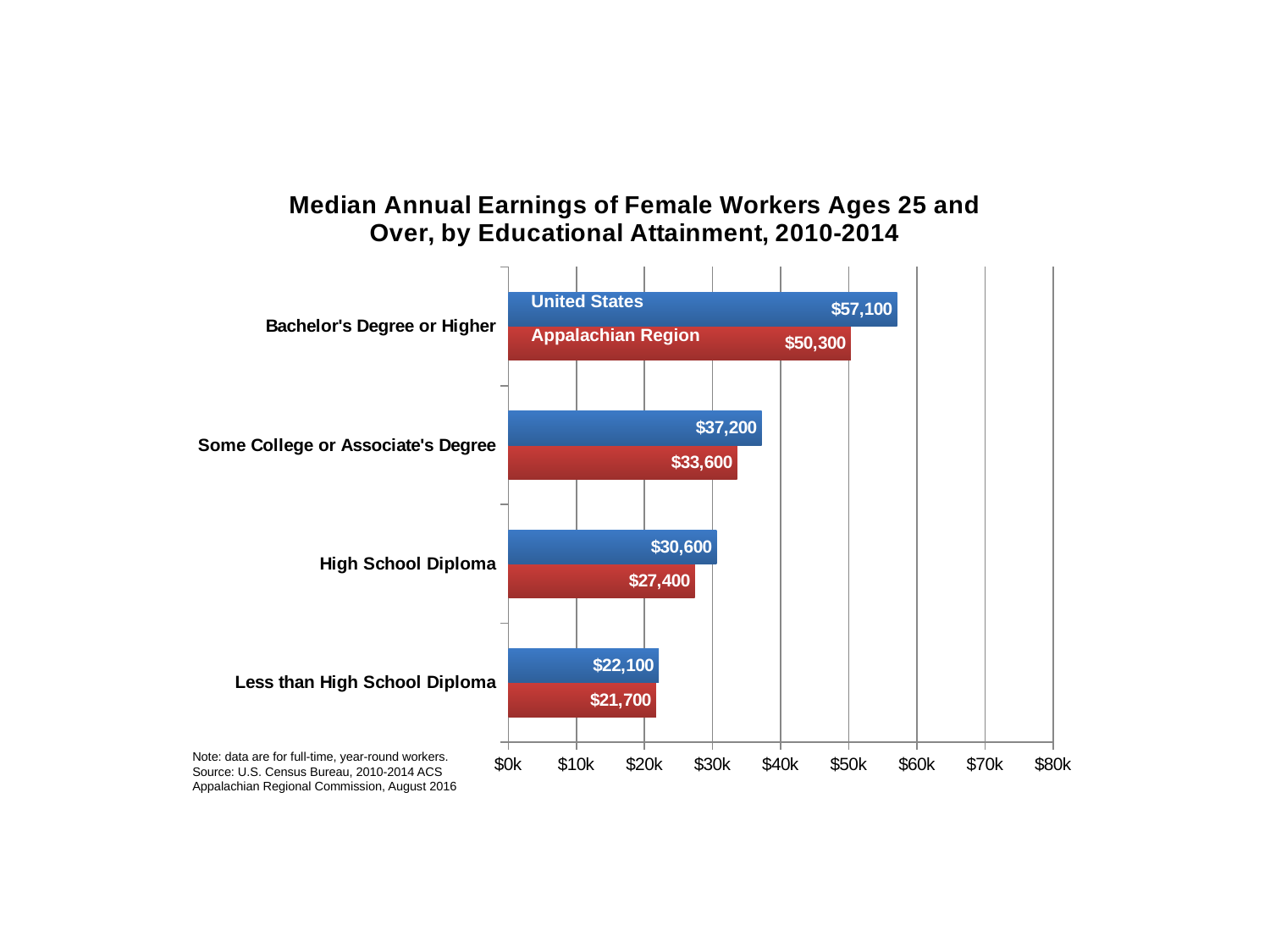
How many educational attainment categories are shown on the chart? 4 Which educational attainment category has the highest median annual earnings for the United States? Bachelor's Degree or Higher Which educational attainment category has the lowest median annual earnings for the Appalachian Region? Less than High School Diploma How many series does the chart show? 2 Which series is shown in red? Appalachian Region Which is larger: United States earnings for High School Diploma or Appalachian Region earnings for Some College or Associate's Degree? Appalachian Region earnings for Some College or Associate's Degree What is the median annual earnings for United States female workers with a Bachelor's Degree or Higher? $57,100 What is the difference between United States and Appalachian Region median earnings for Bachelor's Degree or Higher? $6,800 What is the median annual earnings for Appalachian Region female workers with Some College or Associate's Degree? $33,600 What is the median annual earnings for Appalachian Region female workers with a High School Diploma? $27,400 What kind of chart is shown on the slide? Bar chart What is the difference between United States and Appalachian Region median earnings for Less than High School Diploma? $400